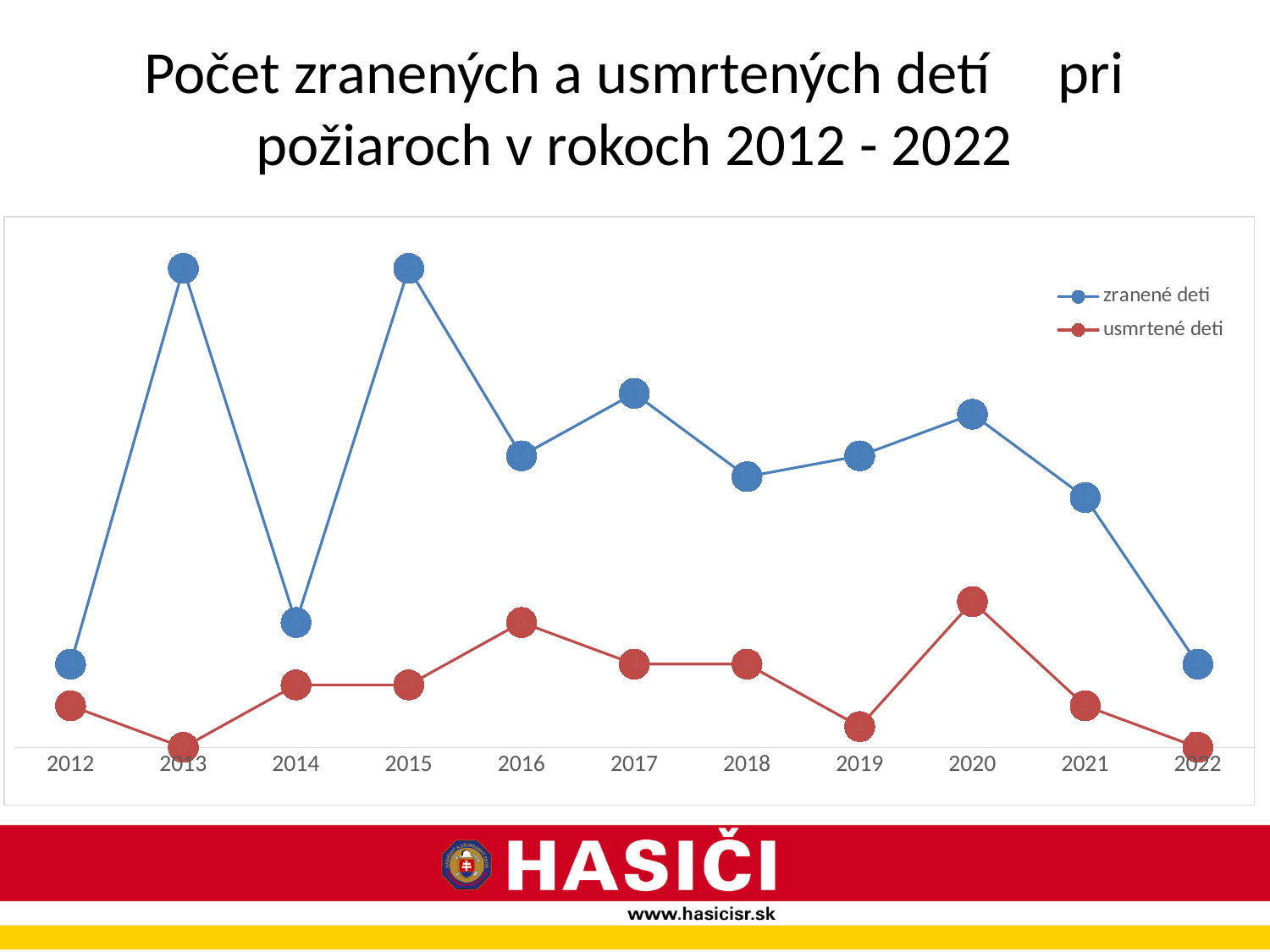
What are the two entries in the legend? zranené deti, usmrtené deti Which is larger for zranené deti: the value in 2014 or the value in 2017? 2017 Which series has the higher value in 2018, zranené deti or usmrtené deti? zranené deti What colour is the line for zranené deti? blue What kind of chart is shown on the slide? line chart Which is larger for zranené deti: the value in 2013 or the value in 2014? 2013 How many series does the legend list? 2 Does the value for usmrtené deti rise or fall from 2019 to 2020? rise In which year is the value for usmrtené deti highest? 2020 Does the value for zranené deti rise or fall from 2020 to 2022? fall How many years are shown on the x axis? 11